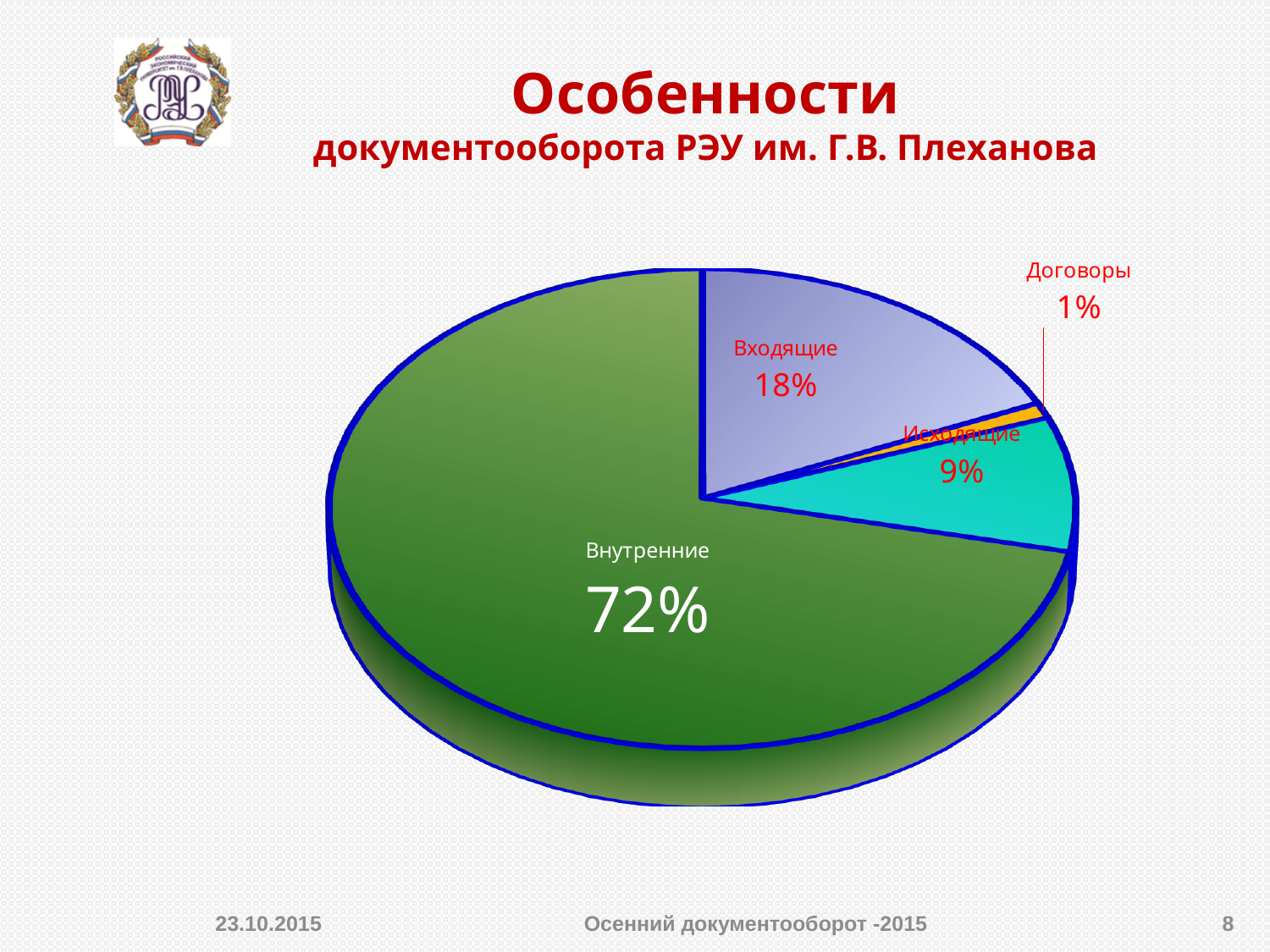
What share of the pie does Внутренние have? 72% Which is larger, Исходящие or Договоры? Исходящие What is the value for Входящие? 18% Which category has the smallest slice? Договоры What is the value for Договоры? 1% What is the difference between Входящие and Исходящие? 9% What colour is the Внутренние slice? green How many categories are shown in the pie chart? 4 What is the difference between Внутренние and Входящие? 54% Which category has the largest slice? Внутренние What is the value for Исходящие? 9% What kind of chart is shown on the slide? pie chart